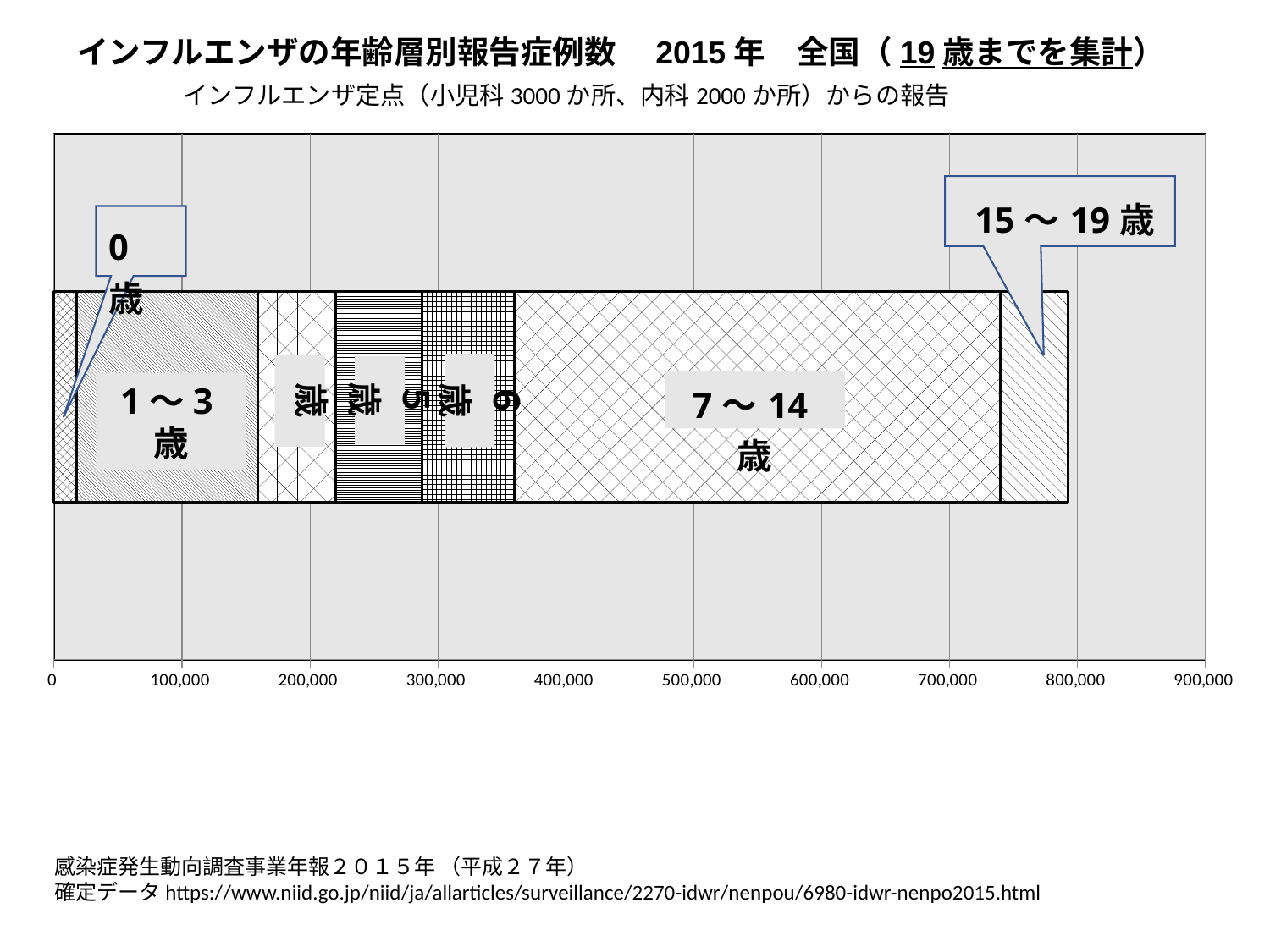
Is the total length of the stacked bar greater or less than 700,000? greater Which age group has the smallest segment in the bar? 0歳 Is the width of the 0歳 segment greater or less than 100,000? less Which year does the chart title say the data is for? 2015年 Is the total length of the stacked bar greater or less than 900,000? less Which segment is larger, 1～3歳 or 15～19歳? 1～3歳 What kind of chart is shown on the slide? Stacked horizontal bar chart What is the maximum value shown on the horizontal axis? 900,000 How many age-group segments make up the bar? 7 Which segment is larger, 7～14歳 or 1～3歳? 7～14歳 Which age group has the largest segment in the bar? 7～14歳